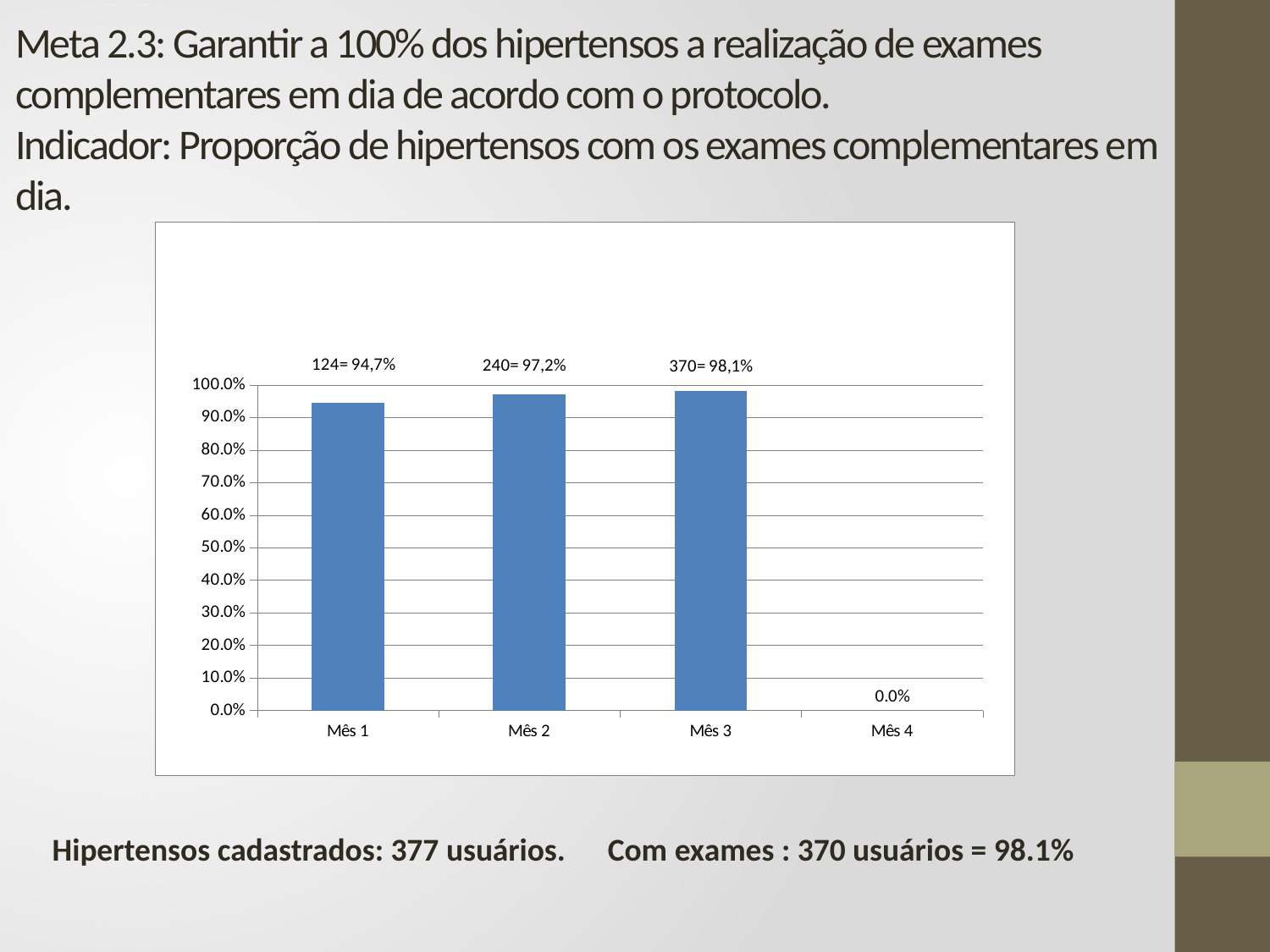
Which month has the lowest value in the chart? Mês 4 Is the value for Mês 1 greater or less than 90.0%? greater What value is shown for Mês 4? 0.0% What kind of chart is shown on the slide? bar chart What is the data label shown above the bar for Mês 2? 240= 97,2% What is the data label shown above the bar for Mês 3? 370= 98,1% Do the percentages rise or fall from Mês 1 to Mês 3? rise What is the data label shown above the bar for Mês 1? 124= 94,7% How many categories are shown on the x axis of the chart? 4 What is the highest tick value shown on the y axis of the chart? 100.0% Which month has the highest percentage in the chart? Mês 3 Which is larger, the percentage for Mês 1 or for Mês 3? Mês 3